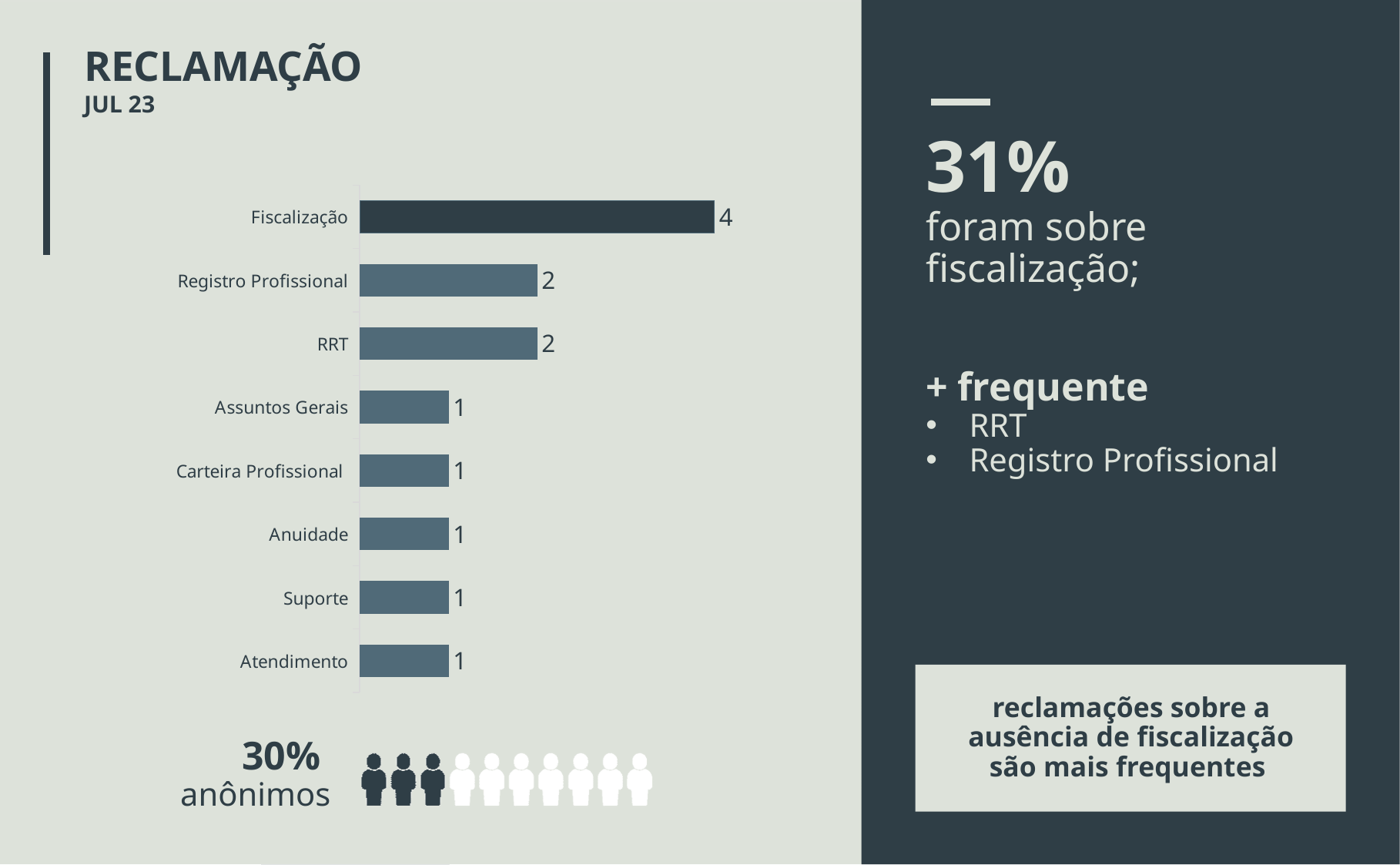
Which category has the highest value? Fiscalização What is the value for Atendimento? 1 What is the value for Suporte? 1 What is the value for Registro Profissional? 2 What is the value for Fiscalização? 4 What is the total of all the values shown in the bar chart? 13 What kind of chart is shown on the slide? Bar chart How many categories are shown in the bar chart? 8 What is the difference between the values for Fiscalização and RRT? 2 How many categories have a value of 1? 5 Which is larger, the value for Registro Profissional or the value for Anuidade? Registro Profissional Which bar is shown in a darker colour than the others? Fiscalização